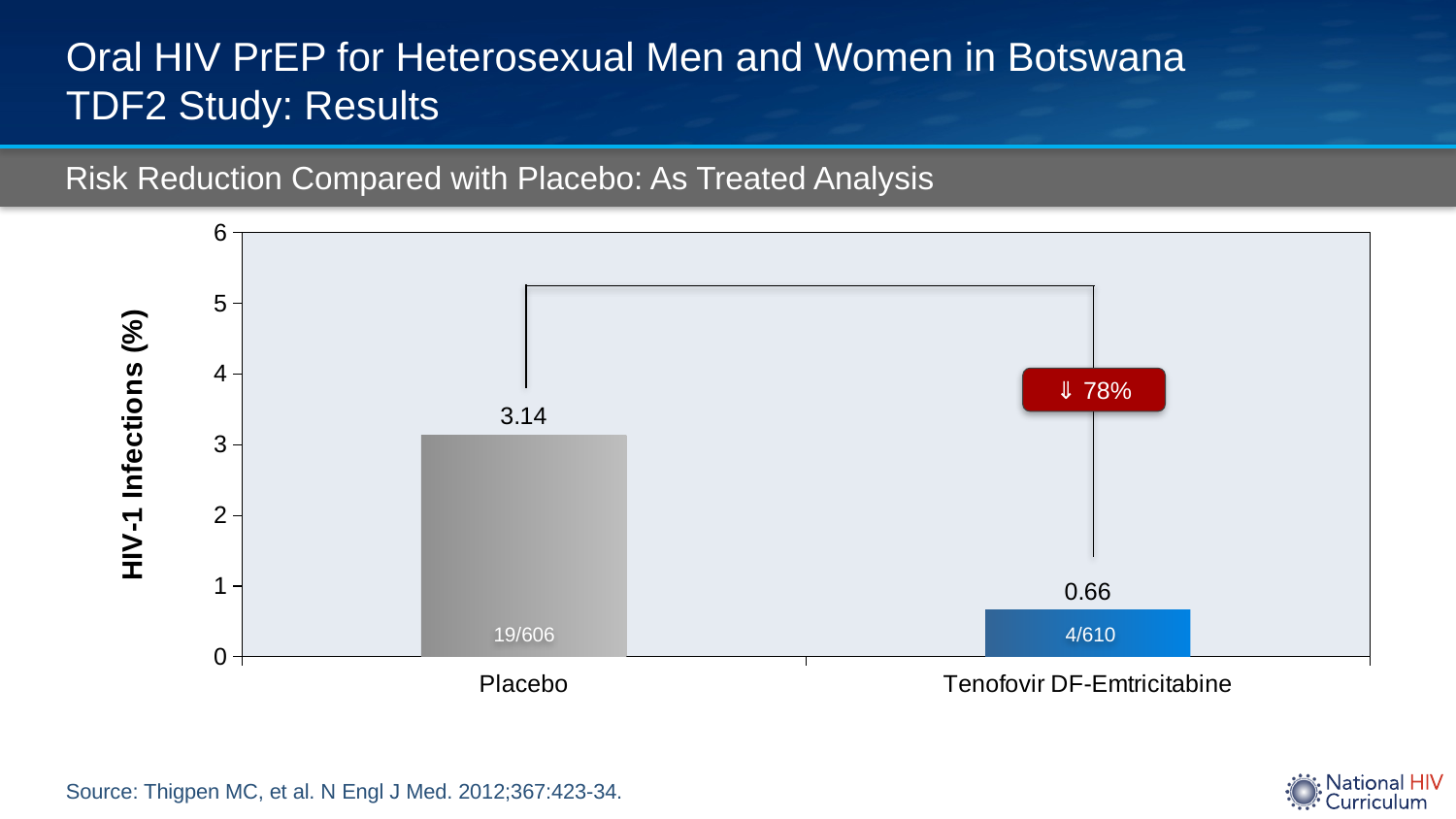
Which group has the lower HIV-1 infection rate? Tenofovir DF-Emtricitabine What fraction of infections is printed on the Placebo bar? 19/606 What fraction of infections is printed on the Tenofovir DF-Emtricitabine bar? 4/610 What is the HIV-1 infection rate (%) for the Placebo group? 3.14 What kind of chart is shown on the slide? Bar chart What is the difference in HIV-1 infection rate (%) between the Placebo and Tenofovir DF-Emtricitabine groups? 2.48 What is the HIV-1 infection rate (%) for the Tenofovir DF-Emtricitabine group? 0.66 What risk reduction percentage is shown in the red box on the chart? 78% Which group has the higher HIV-1 infection rate? Placebo Is the HIV-1 infection rate for Tenofovir DF-Emtricitabine greater or less than 1? less How many groups are shown on the x axis of the chart? 2 Is the HIV-1 infection rate for Placebo greater or less than 3? greater